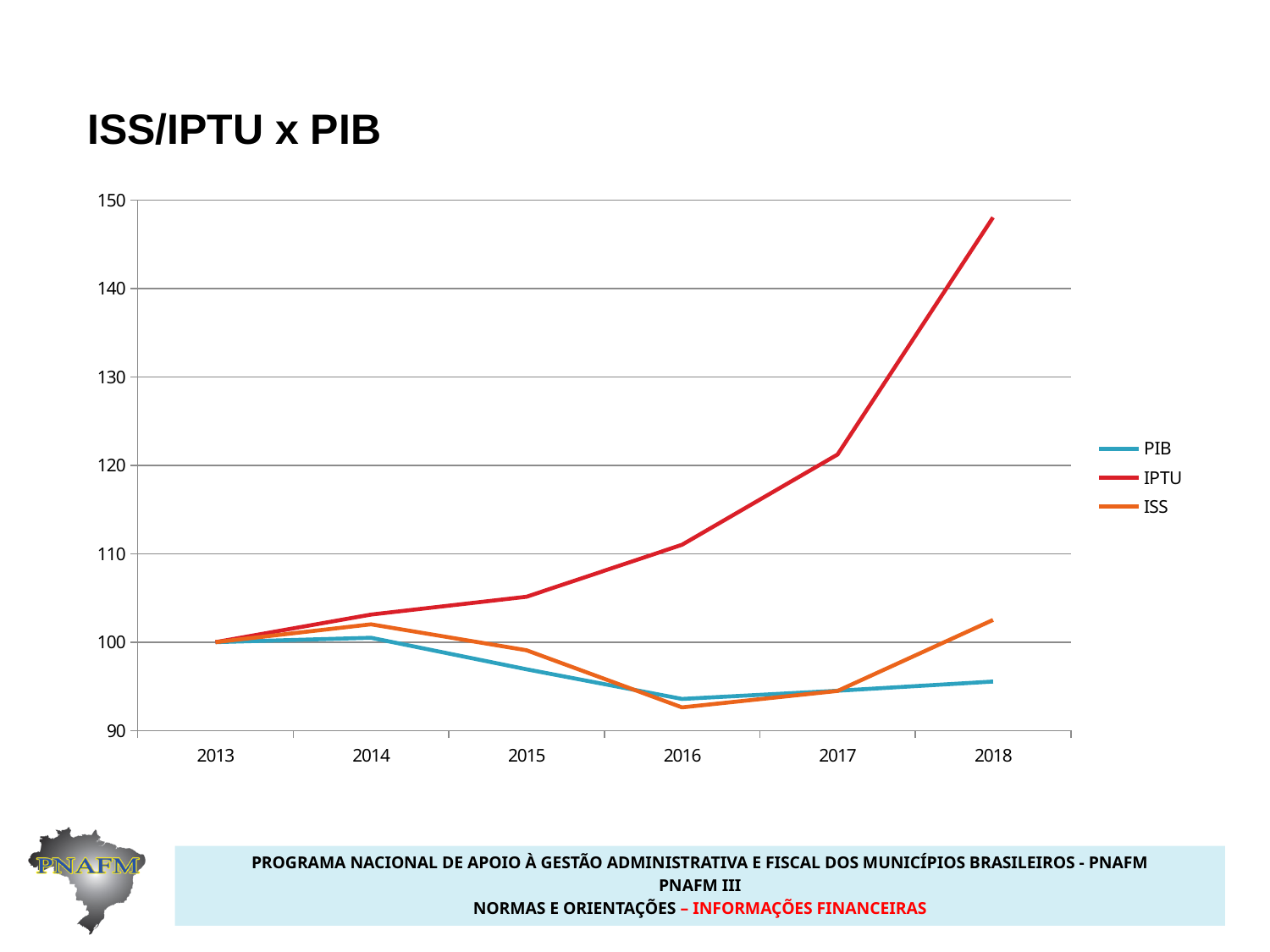
Is the value for PIB in 2018 greater or less than 100? less How many years are shown on the x axis? 6 Is the value for IPTU in 2018 greater or less than 140? greater Which series has the lowest value in 2018? PIB How many series does the legend list? 3 What is the value of IPTU in 2013? 100 Which series has the highest value in 2018? IPTU What is the title of the chart? ISS/IPTU x PIB What kind of chart is shown on the slide? line chart Is the value for ISS in 2016 greater or less than 100? less Which is larger in 2018, ISS or PIB? ISS Does the IPTU series rise or fall from 2013 to 2018? rise